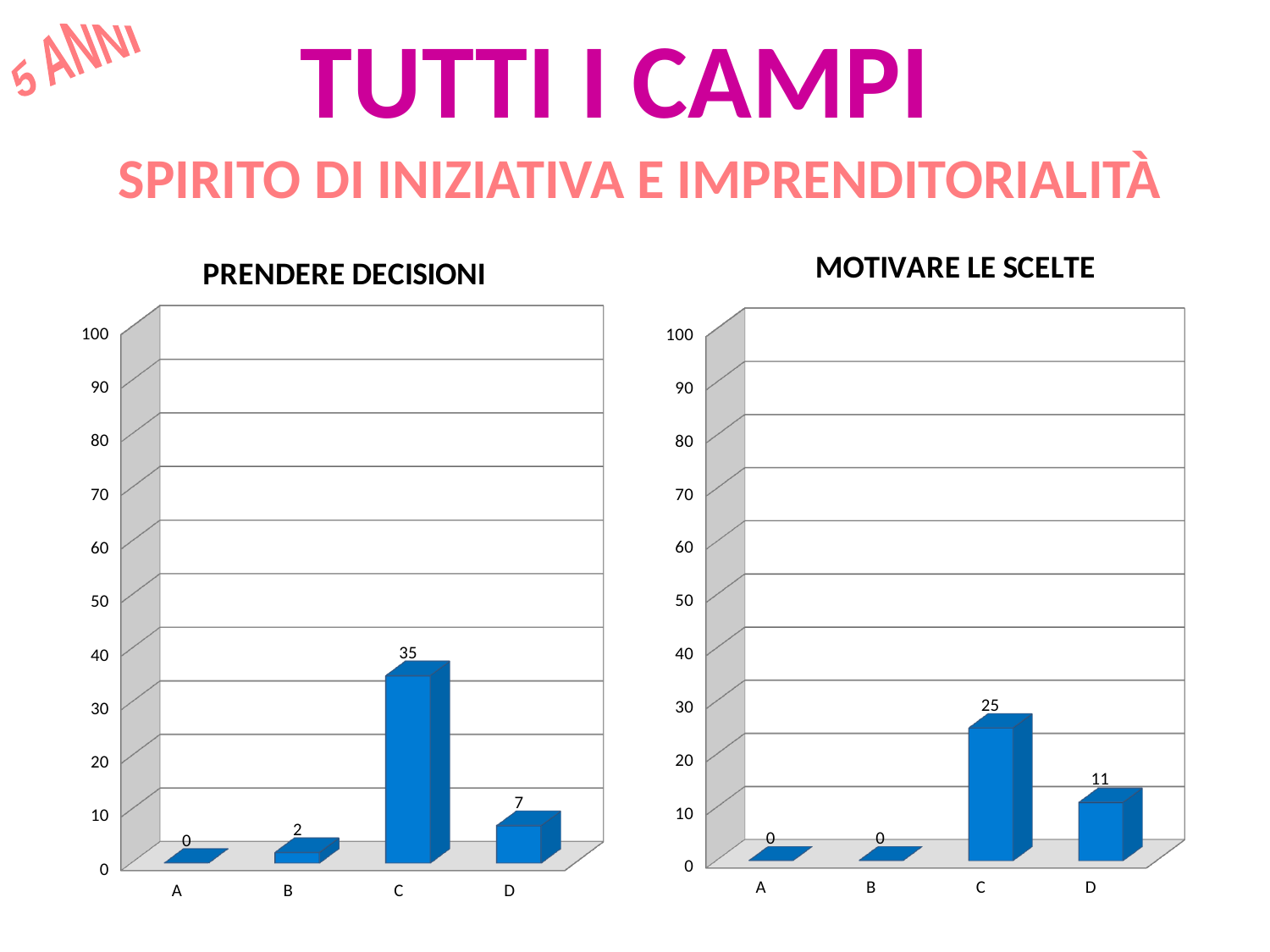
In the PRENDERE DECISIONI chart, what is the difference between the values for C and D? 28 In the MOTIVARE LE SCELTE chart, what is the value for category D? 11 In the PRENDERE DECISIONI chart, which category has the lowest value? A In the MOTIVARE LE SCELTE chart, which category has the highest value? C In the MOTIVARE LE SCELTE chart, what is the difference between the values for C and D? 14 In the MOTIVARE LE SCELTE chart, which is larger, the value for C or the value for D? C In the MOTIVARE LE SCELTE chart, what is the value for category C? 25 In the PRENDERE DECISIONI chart, what is the value for category C? 35 In the PRENDERE DECISIONI chart, what is the value for category B? 2 In the PRENDERE DECISIONI chart, which category has the highest value? C What kind of chart is the MOTIVARE LE SCELTE chart? Bar chart How many categories are shown in the PRENDERE DECISIONI chart? 4